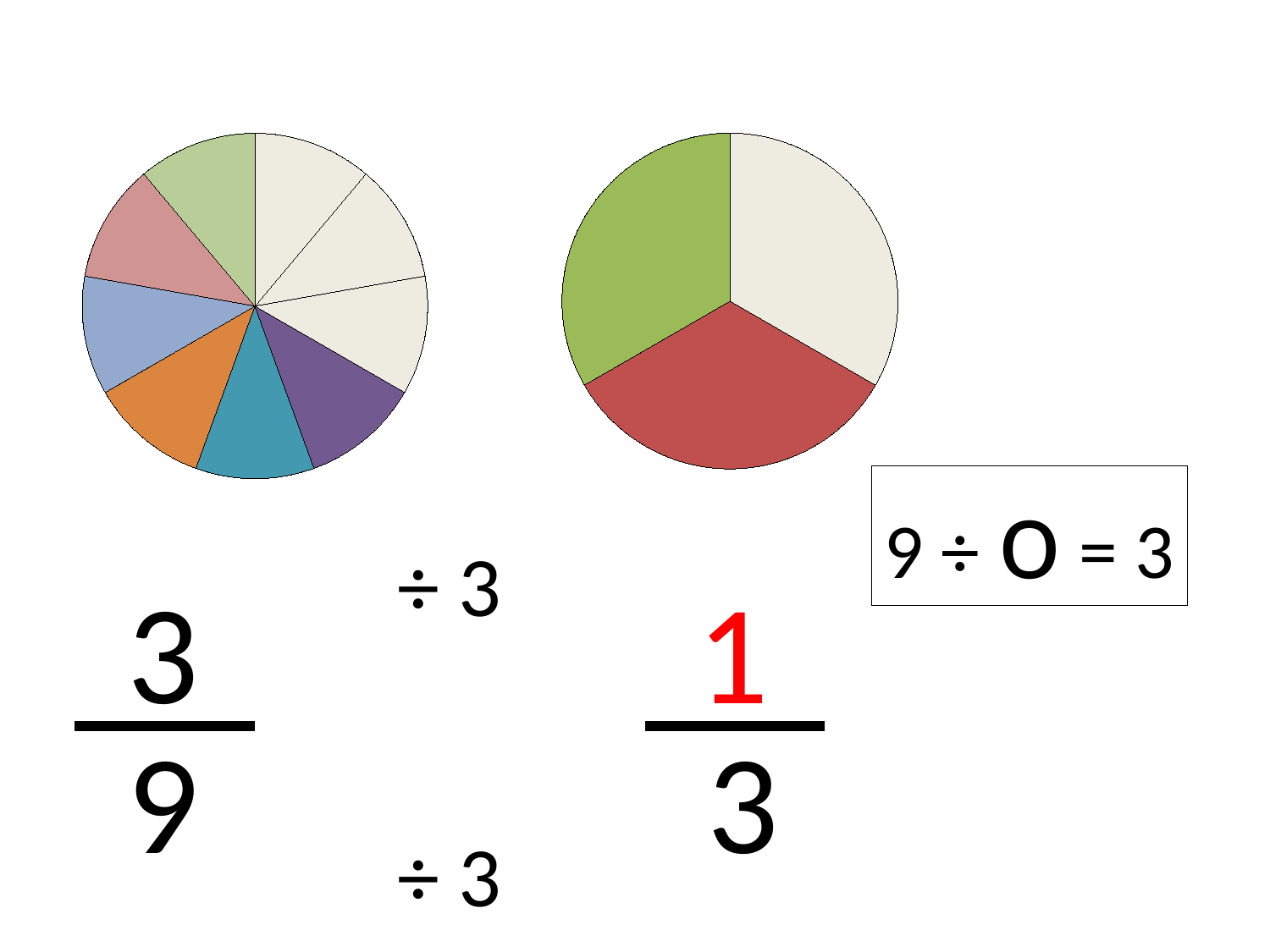
In the pie chart on the left, how many slices are cream-coloured? 3 What kind of chart is the chart on the left of the slide? pie chart How many slices does the pie chart on the right have? 3 What colours are the three slices of the pie chart on the right? green, cream and red In the pie chart on the right, how many slices are cream-coloured? 1 What kind of chart is the chart on the right of the slide? pie chart Does either pie chart on the slide show a legend? No Which pie chart has more slices, the one on the left or the one on the right? the one on the left